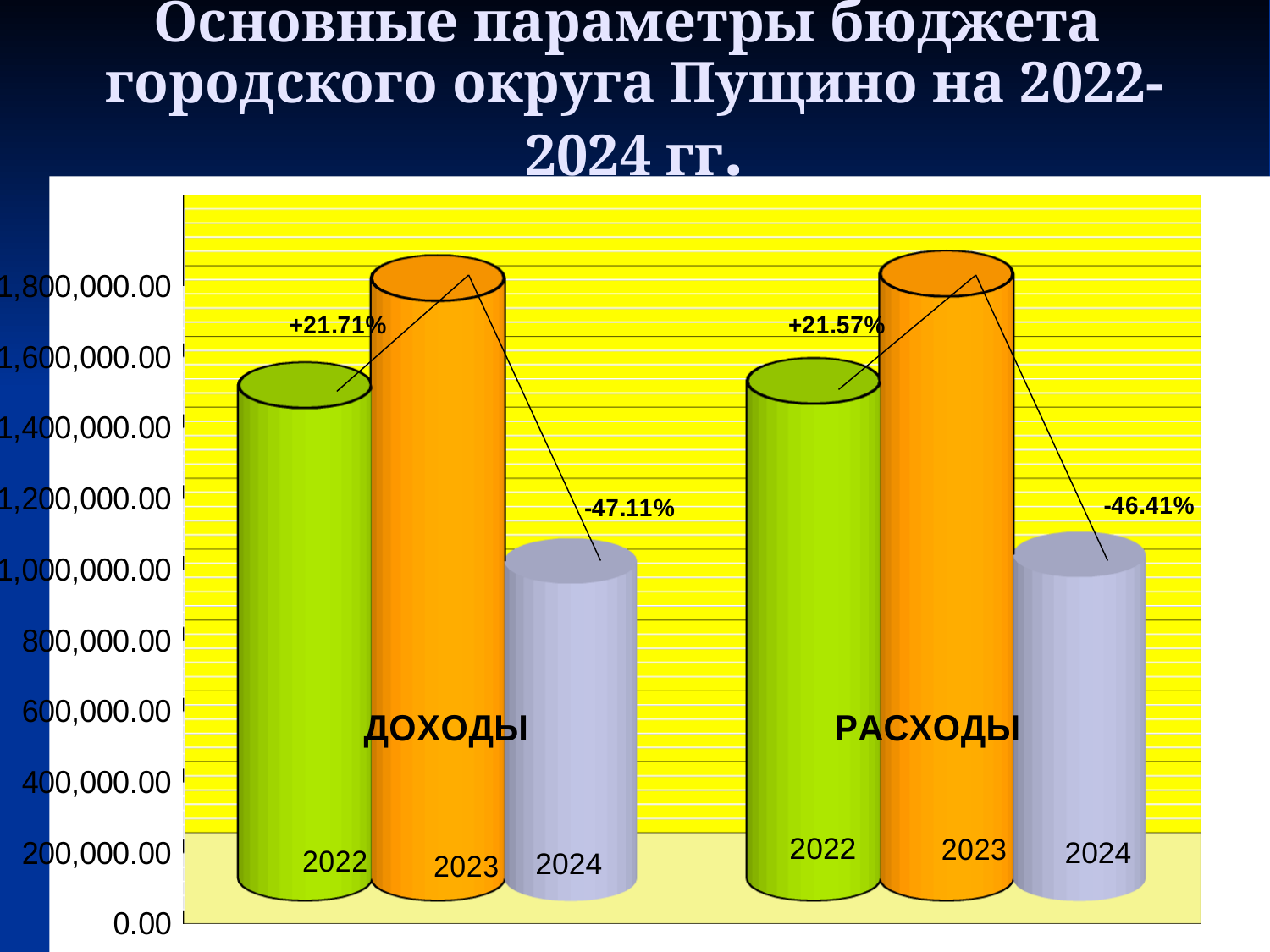
What kind of chart is shown on the slide? bar chart What percentage change is labelled between 2022 and 2023 for РАСХОДЫ? +21.57% Which year has the lowest bar in the РАСХОДЫ group? 2024 Is the value for РАСХОДЫ in 2024 greater or less than 1,200,000.00? less In the ДОХОДЫ group, which bar is taller: 2022 or 2024? 2022 What percentage change is labelled between 2023 and 2024 for ДОХОДЫ? -47.11% What percentage change is labelled between 2022 and 2023 for ДОХОДЫ? +21.71% What percentage change is labelled between 2023 and 2024 for РАСХОДЫ? -46.41% What are the two groups of bars labelled on the chart? ДОХОДЫ and РАСХОДЫ How many bars are plotted in the chart in total? 6 Which year has the highest bar in the ДОХОДЫ group? 2023